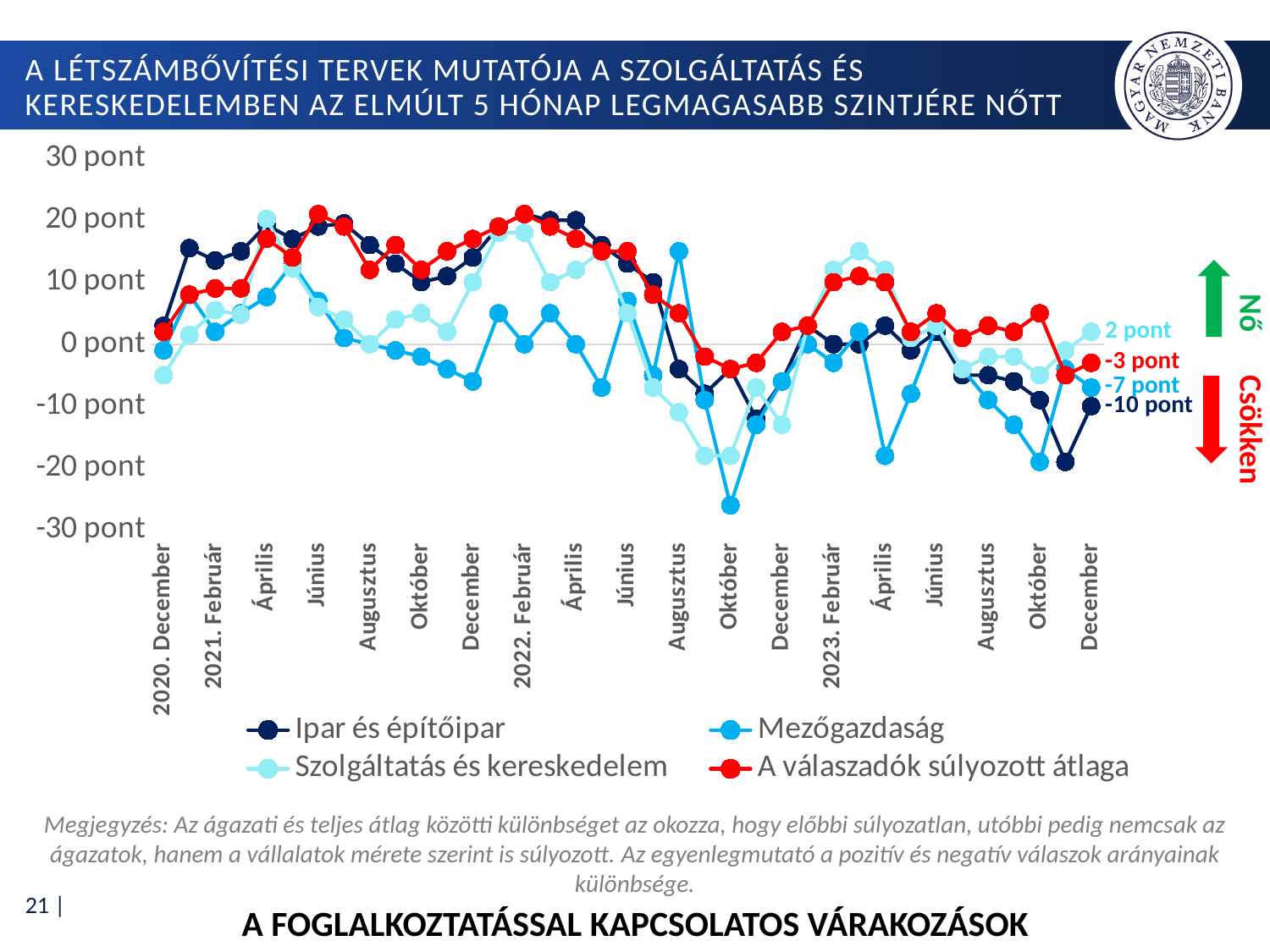
What is the value for Szolgáltatás és kereskedelem in December 2023 (the last point)? 2 pont Which series has the highest value in December 2023? Szolgáltatás és kereskedelem What is the difference between the December 2023 values of Szolgáltatás és kereskedelem and Ipar és építőipar? 12 pont Is the value for Mezőgazdaság in 2022 Október greater or less than -20 pont? less What is the value for Ipar és építőipar in December 2023 (the last point)? -10 pont How many series does the legend list? 4 Which series is drawn in red? A válaszadók súlyozott átlaga What is the value for Mezőgazdaság in December 2023 (the last point)? -7 pont What is the value for A válaszadók súlyozott átlaga in December 2023 (the last point)? -3 pont What kind of chart is shown on the slide? line chart Which series has the lowest value in December 2023? Ipar és építőipar In December 2023, which is larger: the value for Mezőgazdaság or the value for A válaszadók súlyozott átlaga? A válaszadók súlyozott átlaga